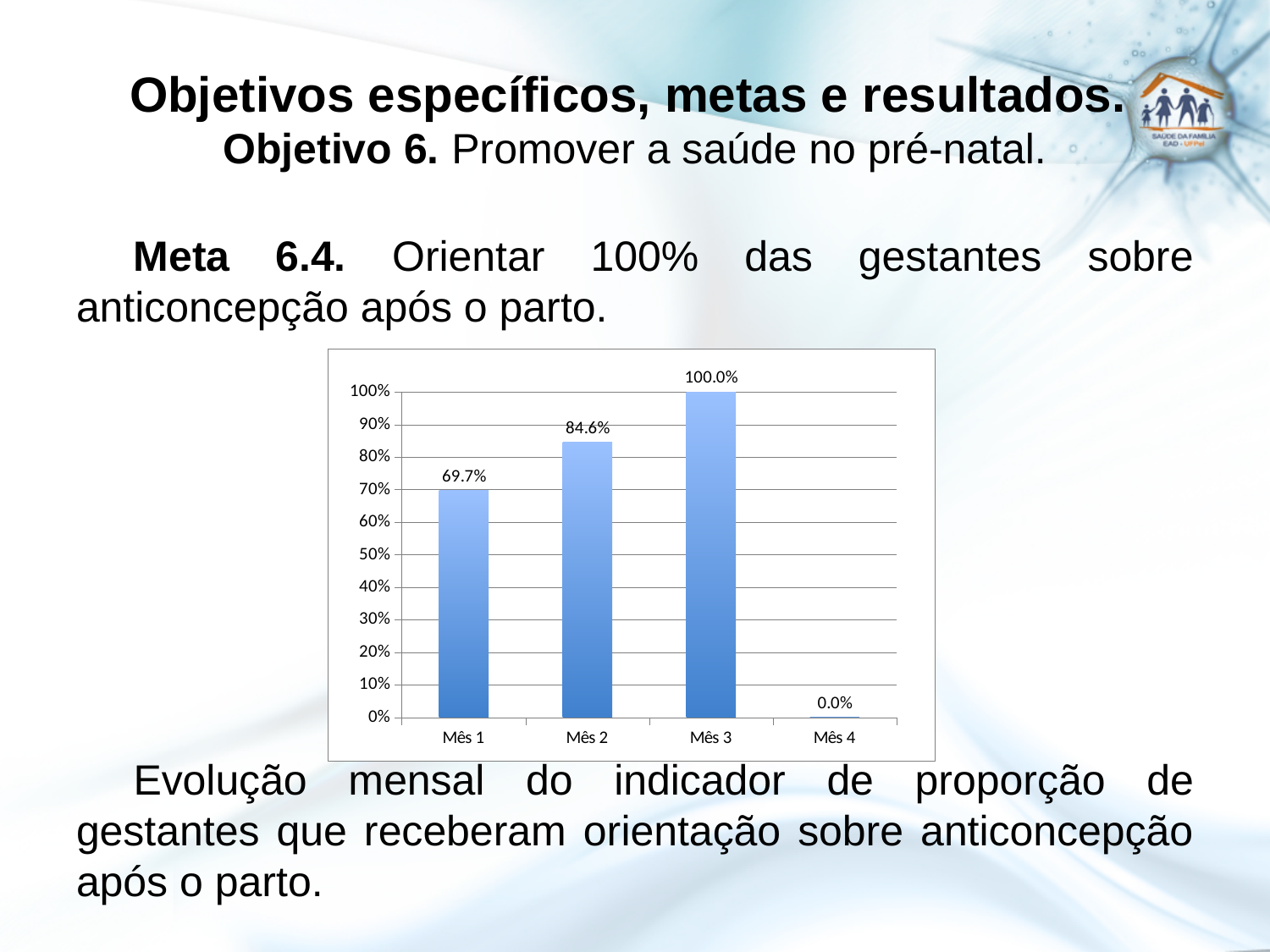
What kind of chart is shown on the slide? bar chart What is the difference between the values for Mês 2 and Mês 1? 14.9% Which is larger, the value for Mês 2 or the value for Mês 1? Mês 2 What is the value for Mês 2? 84.6% What is the difference between the values for Mês 3 and Mês 1? 30.3% What is the value for Mês 3? 100.0% Which month has the highest value? Mês 3 What is the value for Mês 1? 69.7% Which month has the lowest value? Mês 4 What is the value for Mês 4? 0.0% Is the value for Mês 2 greater or less than 80%? greater How many months are shown on the x axis? 4